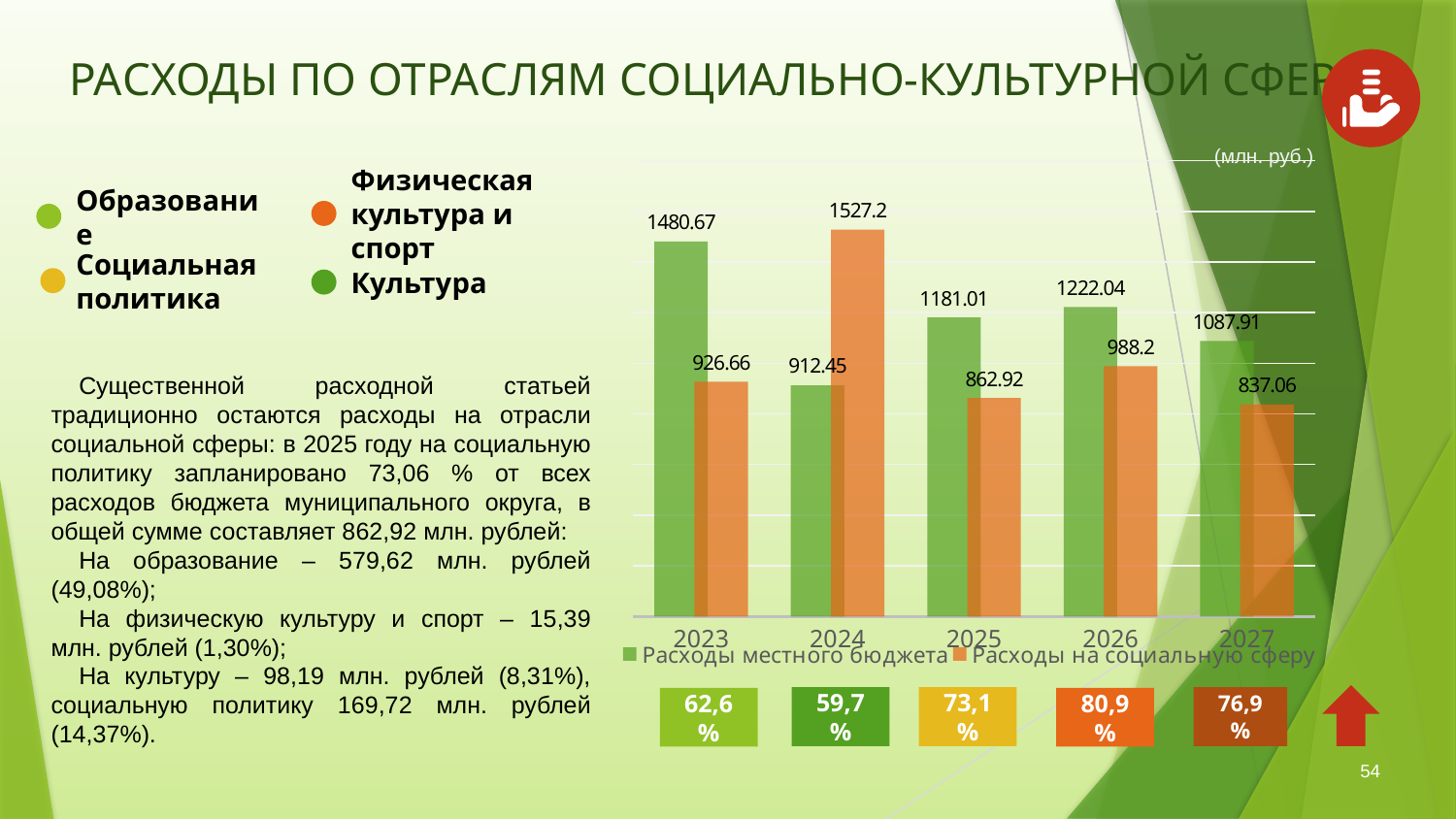
Which is larger in 2024: Расходы местного бюджета or Расходы на социальную сферу? Расходы на социальную сферу What type of chart is shown on the slide? bar chart How many series does the chart legend list? 2 What is the difference between Расходы местного бюджета and Расходы на социальную сферу in 2026? 233.84 What is the value for Расходы на социальную сферу in 2024? 1527.2 What is the value for Расходы местного бюджета in 2027? 1087.91 What is the value for Расходы местного бюджета in 2023? 1480.67 What is the value for Расходы на социальную сферу in 2025? 862.92 How many years are shown on the x axis of the chart? 5 What unit is indicated for the chart values? млн. руб. In which year is Расходы местного бюджета the highest? 2023 In which year is Расходы на социальную сферу the lowest? 2027